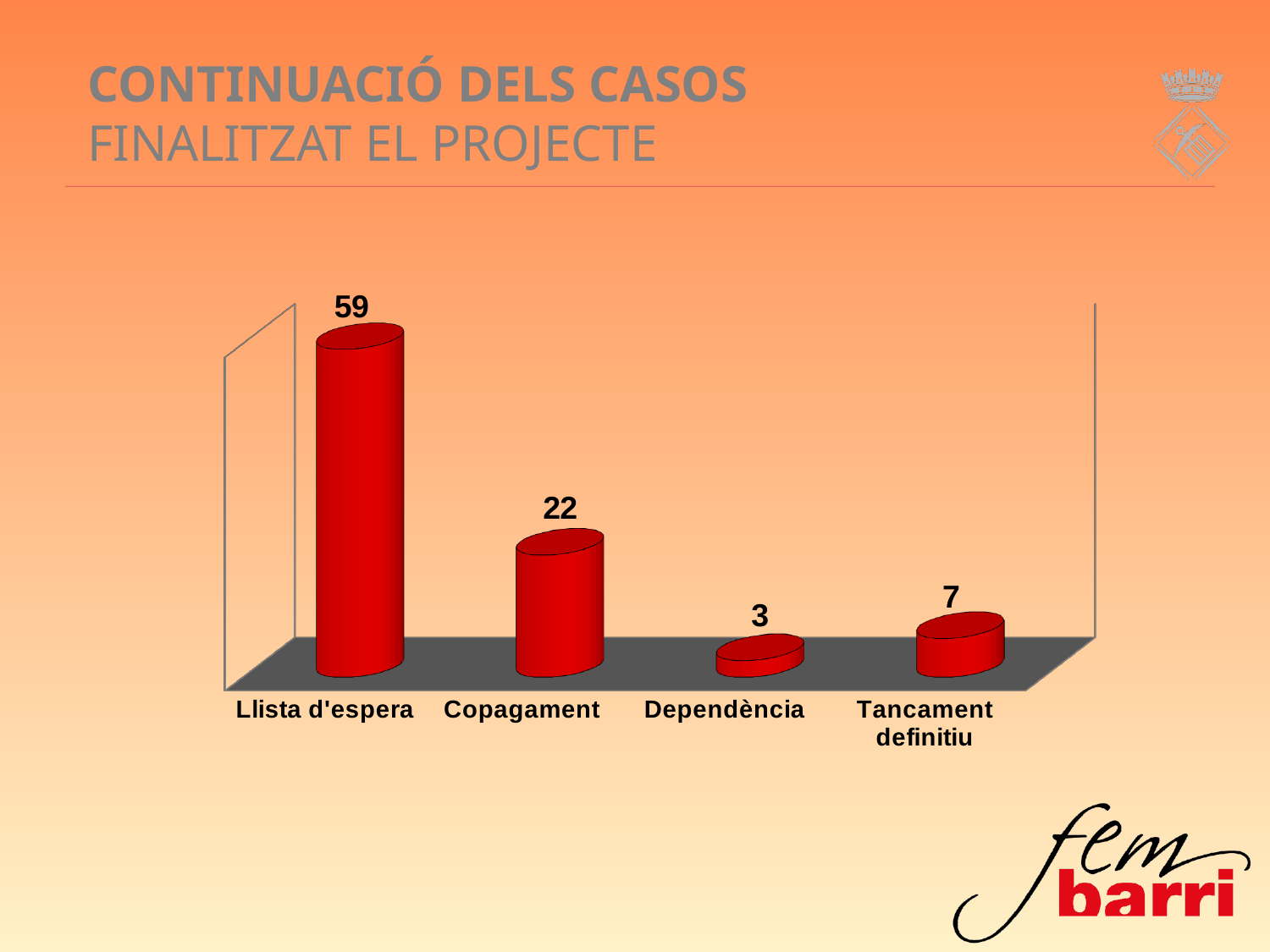
What is the value for Copagament? 22 Which category has the lowest value? Dependència Which is larger, the value for Copagament or the value for Tancament definitiu? Copagament What is the difference between the values for Tancament definitiu and Dependència? 4 How many categories are shown in the chart? 4 What is the difference between the values for Llista d'espera and Copagament? 37 What is the value for Dependència? 3 What kind of chart is shown on the slide? Bar chart What is the value for Tancament definitiu? 7 Which category has the highest value? Llista d'espera What is the value for Llista d'espera? 59 What colour are the bars in the chart? Red